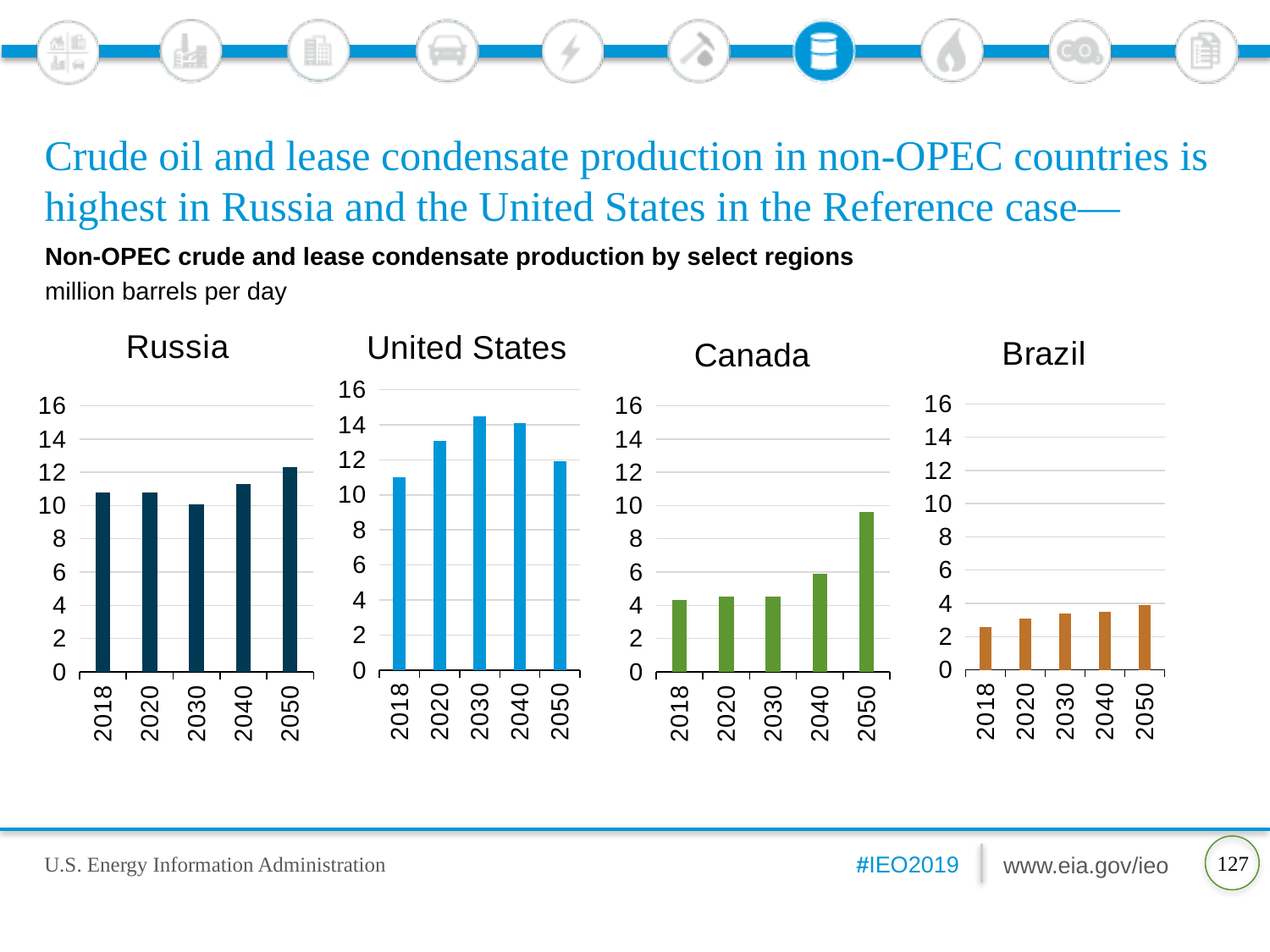
In the Brazil chart, which year has the lowest production? 2018 In the Brazil chart, is the value for 2018 greater or less than 2? greater How many years are plotted in the Brazil chart? 5 In the Canada chart, is the value for 2050 greater or less than 10? less In the Russia chart, which year has the highest production? 2050 What kind of chart is used for the Russia panel? bar chart In the United States chart, which year has the lowest production? 2018 Which is larger: the 2030 value in the United States chart or the 2030 value in the Russia chart? United States In the Canada chart, which year has the highest production? 2050 In the Russia chart, is the value for 2050 greater or less than 12? greater In the Russia chart, which year has the lowest production? 2030 In the United States chart, which year has the highest production? 2030